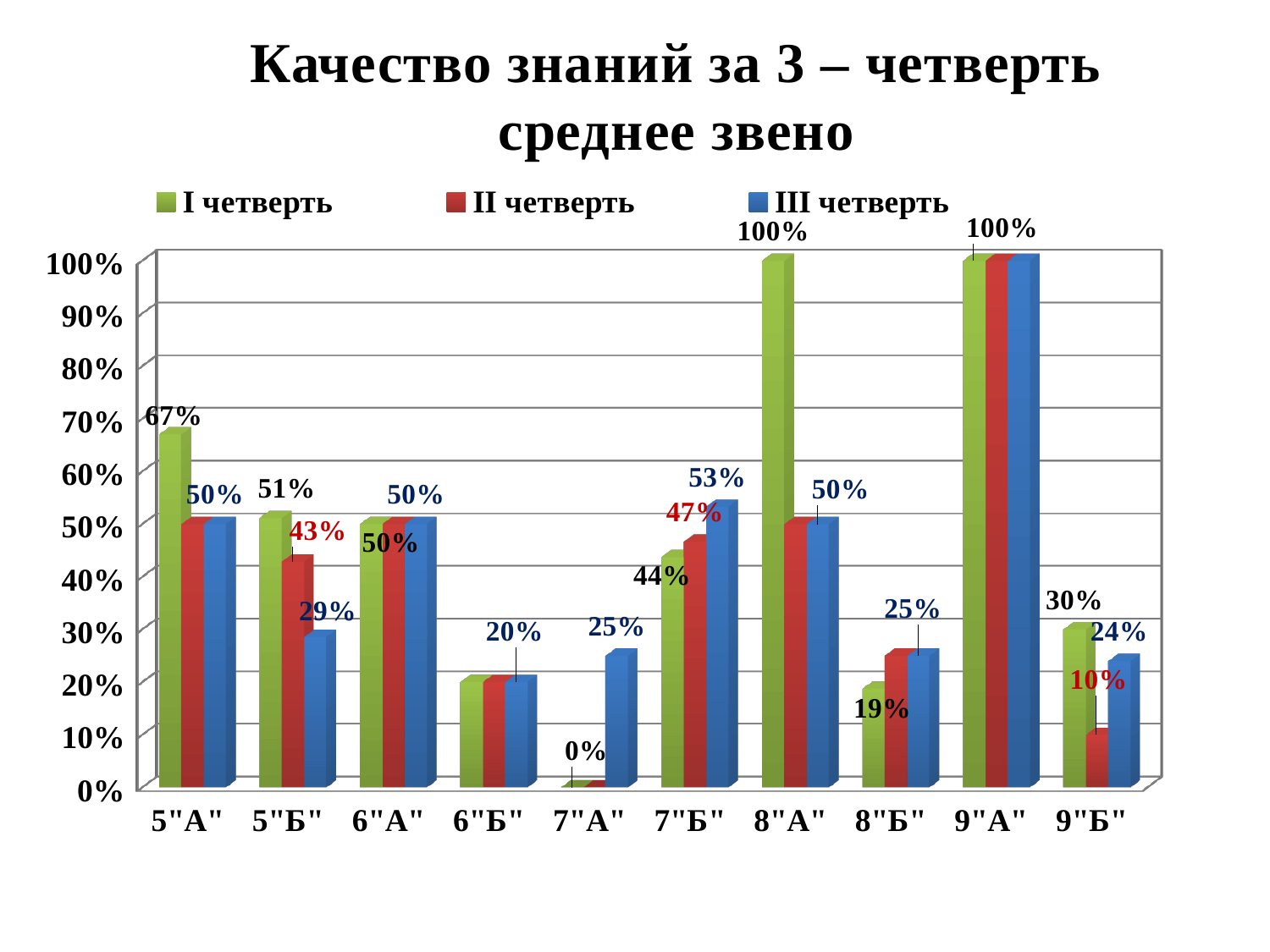
How many classes (categories) are shown on the x axis? 10 What is the value for II четверть for class 9"Б"? 10% What is the value for I четверть for class 5"А"? 67% What is the difference between the I четверть and III четверть values for class 5"Б"? 22% How many series does the legend list? 3 Which class has the lowest I четверть value? 7"А" What kind of chart is shown on the slide? bar chart What is the value for III четверть for class 7"Б"? 53% Which series is shown in green in the legend? I четверть Is the II четверть value for class 8"А" greater or less than 60%? less Which is larger: the I четверть value for 5"А" or for 5"Б"? 5"А" What is the value for III четверть for class 5"Б"? 29%